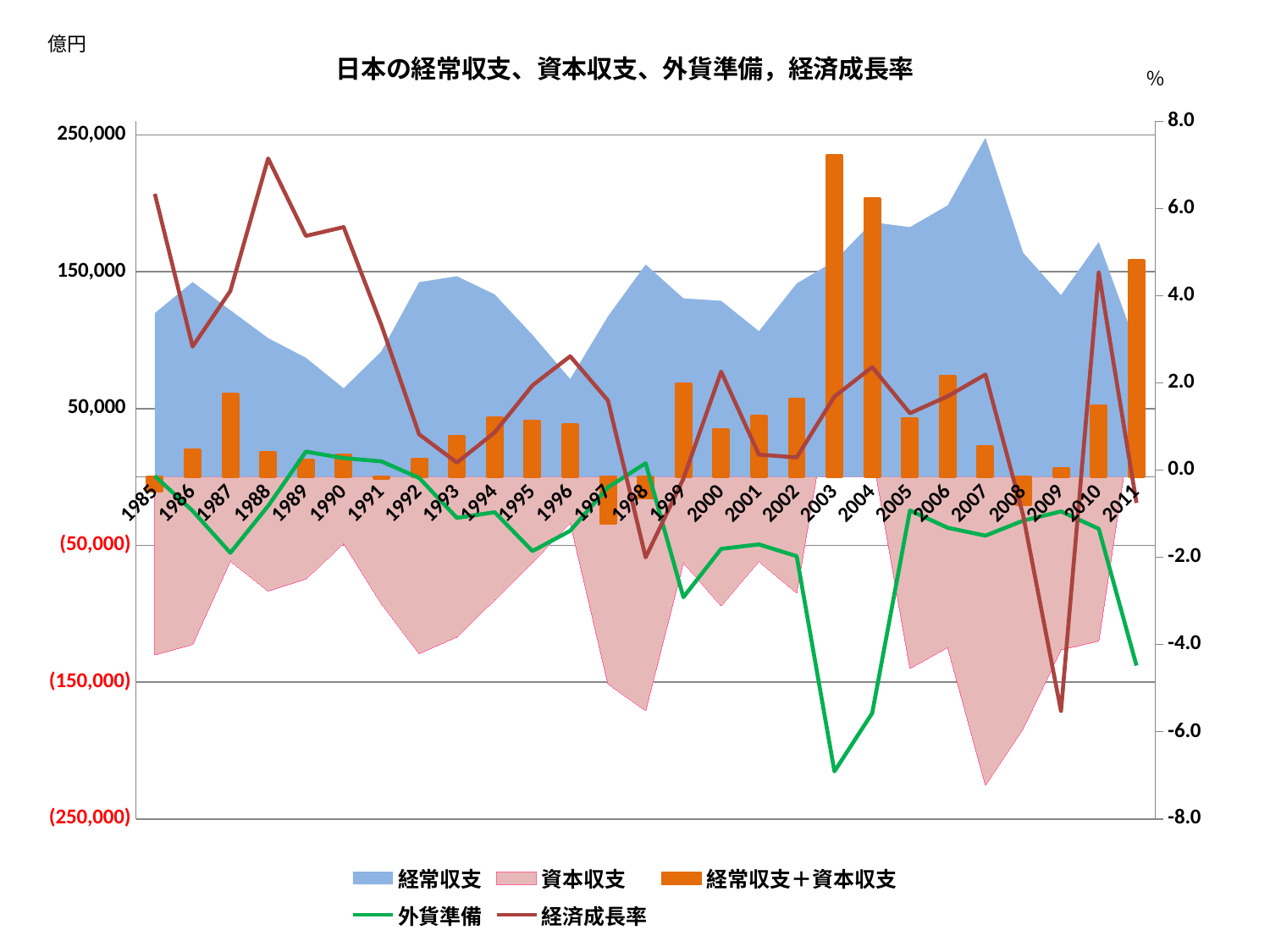
In which year does the 経済成長率 line reach its highest value? 1988 In which year is the 経常収支＋資本収支 bar the highest? 2003 Is the 経済成長率 value for 2009 greater or less than -4.0? less Does the 経常収支 area rise or fall from 2007 to 2009? fall What is the title of the chart? 日本の経常収支、資本収支、外貨準備，経済成長率 Is the 経常収支＋資本収支 value for 2003 greater or less than 150,000? greater In which year does the 経済成長率 line reach its lowest value? 2009 How many years are shown on the x axis? 27 Which year has the larger 経常収支＋資本収支 bar, 2003 or 2004? 2003 What kind of chart is this? Combination chart with area, bar and line series How many series does the legend list? 5 In which year does the 外貨準備 line reach its lowest value? 2003